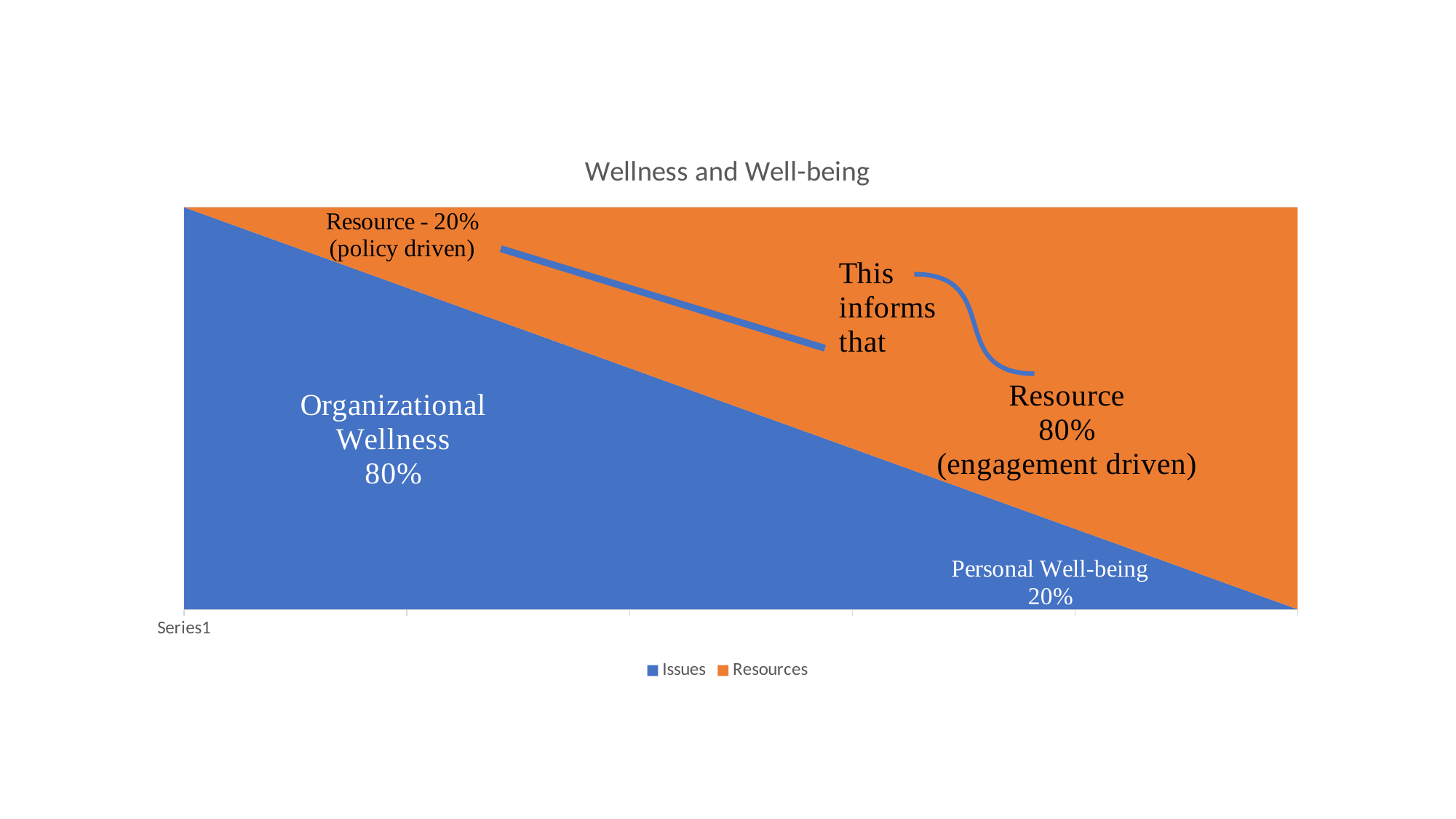
What percentage is labelled for Personal Well-being on the chart? 20% Which series is shown in blue? Issues What percentage is labelled for Organizational Wellness on the chart? 80% What percentage is labelled for the policy-driven Resource on the chart? 20% Which is larger, the labelled percentage for Organizational Wellness or for Personal Well-being? Organizational Wellness Does the orange Resources area grow or shrink from left to right across the chart? Grow What is the title of the chart? Wellness and Well-being What kind of chart is shown on the slide? Area chart What percentage is labelled for the engagement-driven Resource on the chart? 80% Does the blue Issues area rise or fall from left to right across the chart? Fall What are the two series named in the legend? Issues and Resources How many series does the chart's legend list? 2